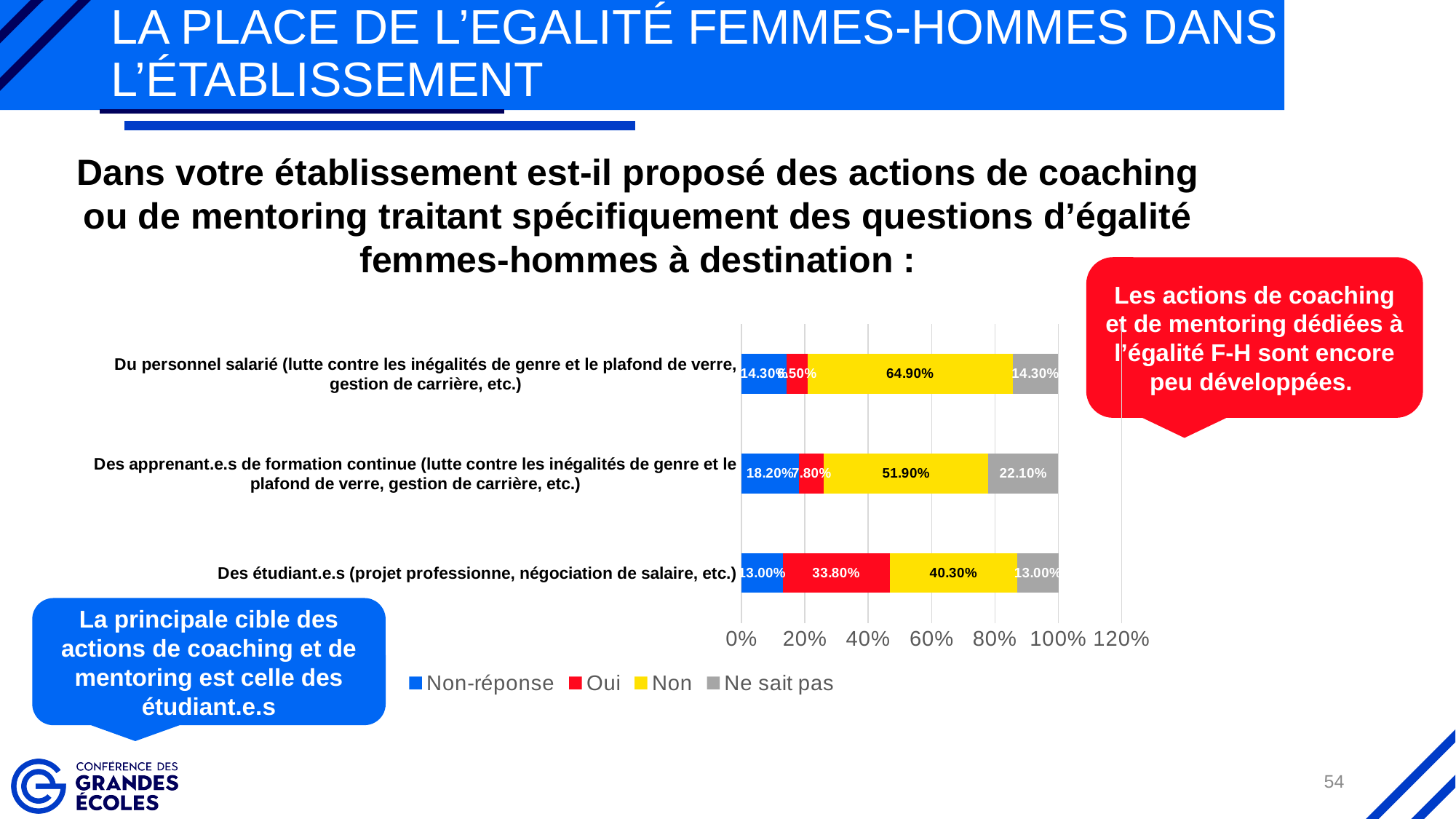
Which category has the highest 'Non' value? Du personnel salarié How many categories (target groups) are plotted in the chart? 3 What is the 'Non' value for 'Du personnel salarié'? 64.90% What kind of chart is shown on the slide? Stacked bar chart What are the four legend entries of the chart? Non-réponse, Oui, Non, Ne sait pas For 'Des étudiant.e.s', what is the difference between the 'Non' value and the 'Oui' value? 6.50% What is the 'Ne sait pas' value for 'Des apprenant.e.s de formation continue'? 22.10% Which category has the larger 'Ne sait pas' value: 'Du personnel salarié' or 'Des apprenant.e.s de formation continue'? Des apprenant.e.s de formation continue What is the 'Non-réponse' value for 'Des apprenant.e.s de formation continue'? 18.20% Which category has the highest 'Oui' value? Des étudiant.e.s (projet professionne, négociation de salaire, etc.) How many series does the legend list? 4 What is the 'Oui' value for 'Des étudiant.e.s (projet professionne, négociation de salaire, etc.)'? 33.80%